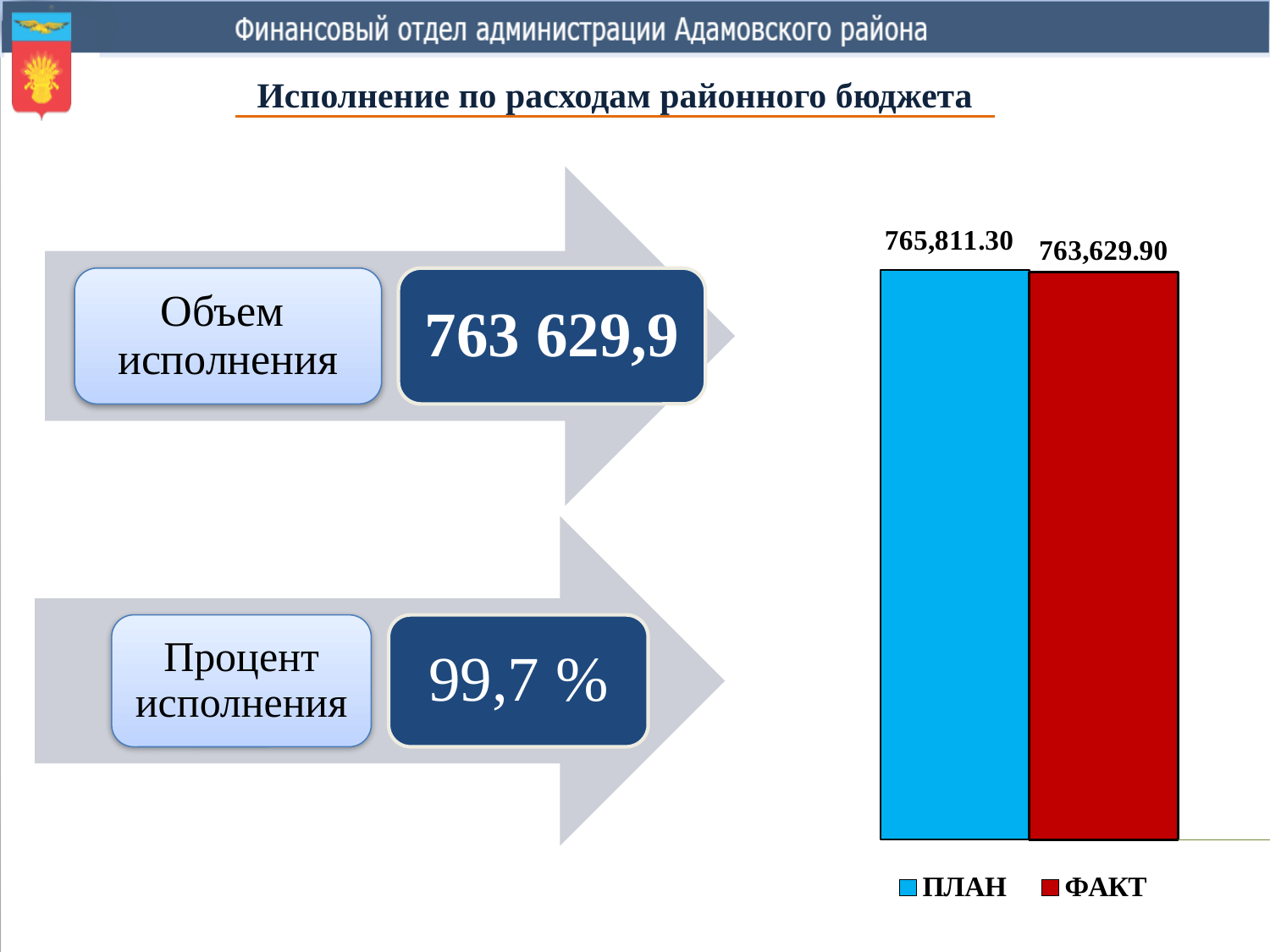
How many series does the legend list? 2 How many bars are plotted in the chart? 2 What colour is the ФАКТ bar? red What is the value of the ПЛАН bar? 765,811.30 Which bar is higher, ПЛАН or ФАКТ? ПЛАН What colour is the ПЛАН bar? light blue Which series has the lowest value in the chart? ФАКТ Which series has the highest value in the chart? ПЛАН What is the value of the ФАКТ bar? 763,629.90 What kind of chart is shown on the slide? bar chart What is the difference between the ПЛАН and ФАКТ values? 2,181.40